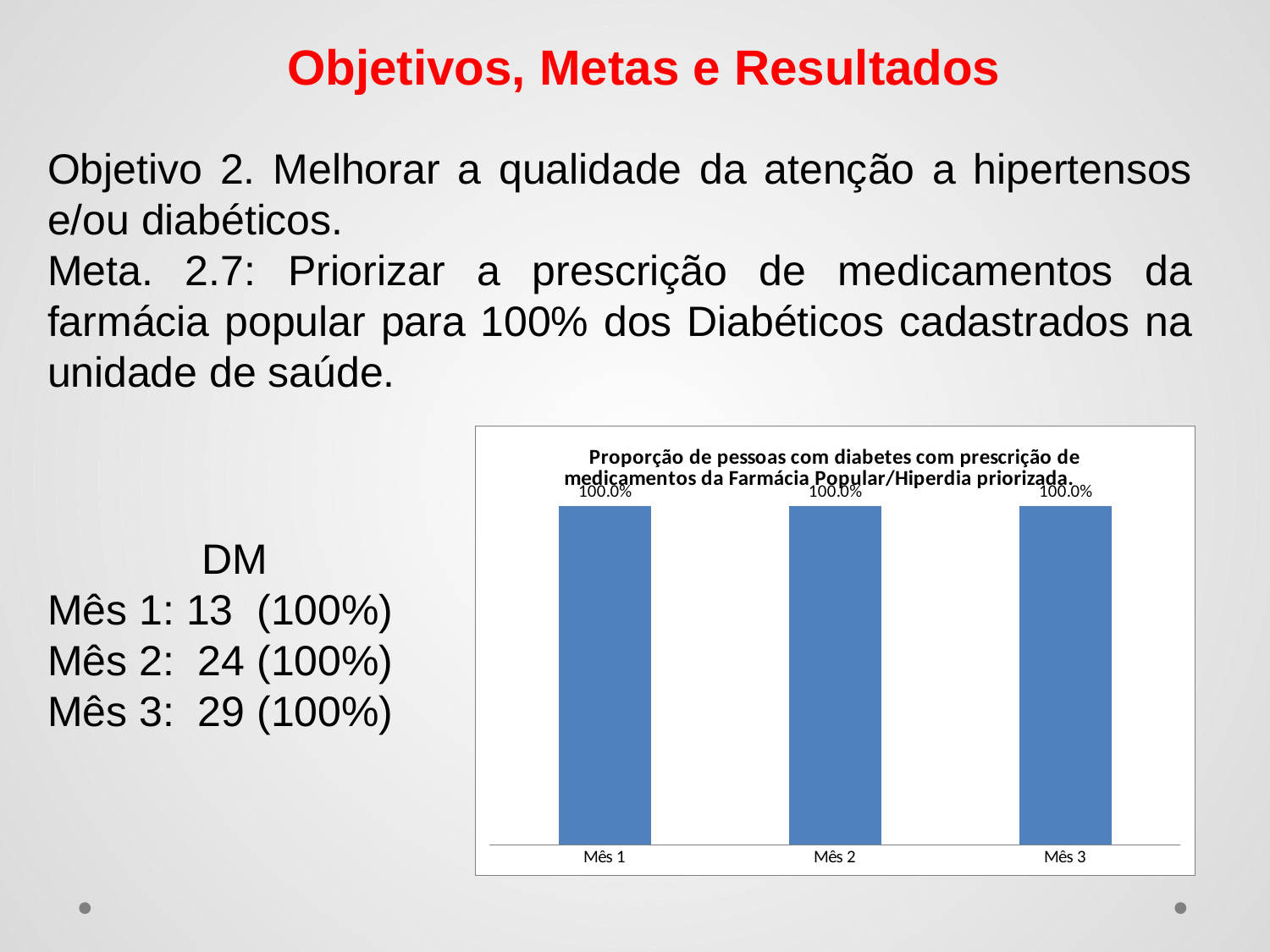
What kind of chart is shown on the slide? Bar chart What is the difference between the values for Mês 3 and Mês 1? 0.0% What is the title of the chart? Proporção de pessoas com diabetes com prescrição de medicamentos da Farmácia Popular/Hiperdia priorizada. What colour are the bars in the chart? Blue How many categories are shown on the x axis of the chart? 3 Do the values rise, fall or stay the same from Mês 1 to Mês 3? Stay the same What is the label of the first category on the x axis? Mês 1 What is the value for Mês 3 in the chart? 100.0% What is the value for Mês 1 in the chart? 100.0% What is the label of the last category on the x axis? Mês 3 What is the value for Mês 2 in the chart? 100.0% Is the value for Mês 2 larger than, smaller than, or equal to the value for Mês 1? Equal